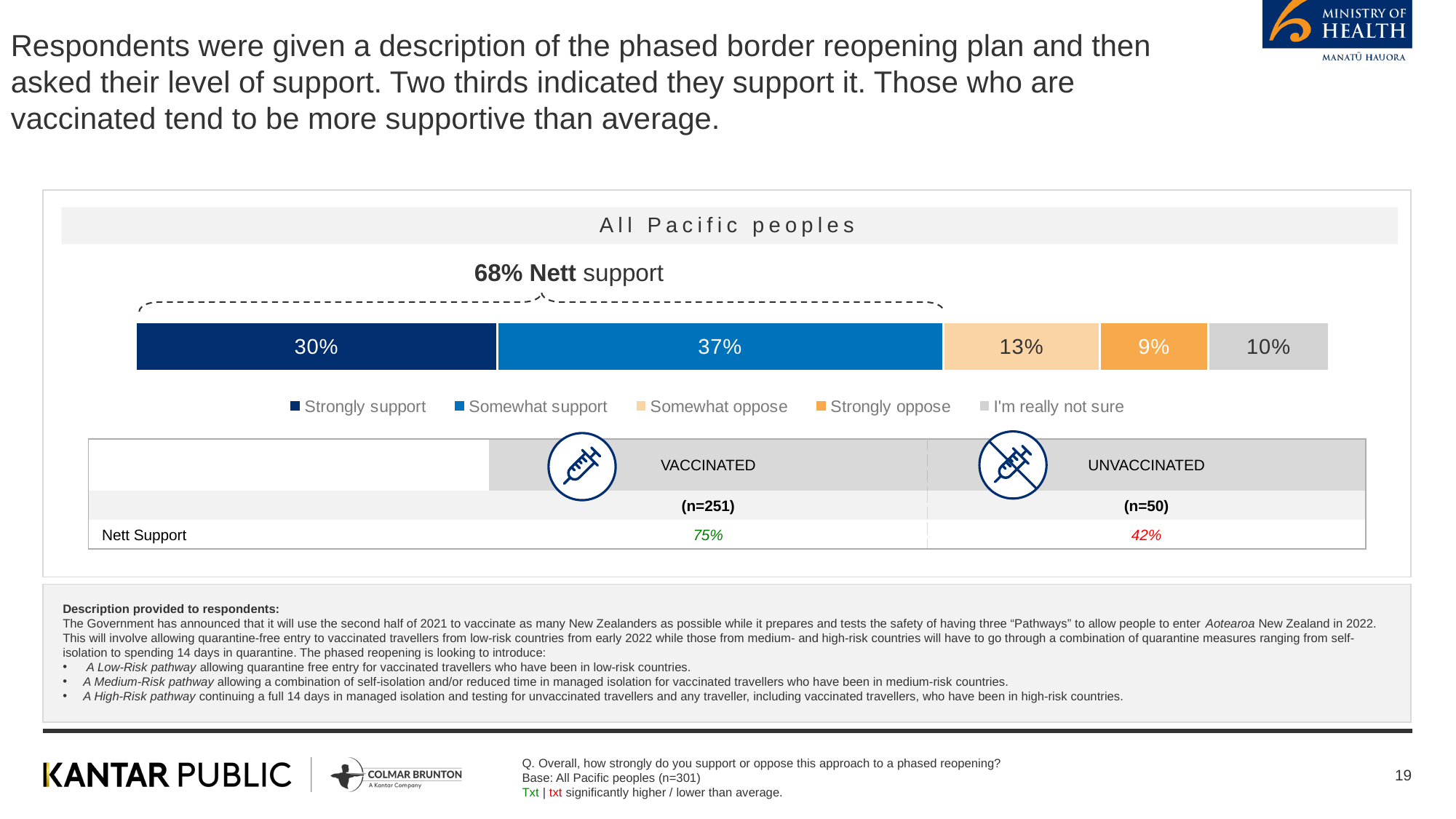
Which is larger: the Somewhat oppose share or the Strongly oppose share? Somewhat oppose What percentage of All Pacific peoples somewhat support the plan? 37% What is the difference between the Somewhat support and Strongly support percentages? 7% Which response category has the largest share in the All Pacific peoples bar? Somewhat support What is the combined percentage of Strongly support and Somewhat support (Nett support)? 67% What percentage of All Pacific peoples strongly oppose the plan? 9% What percentage of All Pacific peoples answered 'I'm really not sure'? 10% What is the title shown above the chart? All Pacific peoples What kind of chart is shown on the slide? Stacked bar chart What percentage of All Pacific peoples strongly support the phased border reopening plan? 30% Which response category has the smallest share in the All Pacific peoples bar? Strongly oppose How many response categories does the legend list? 5